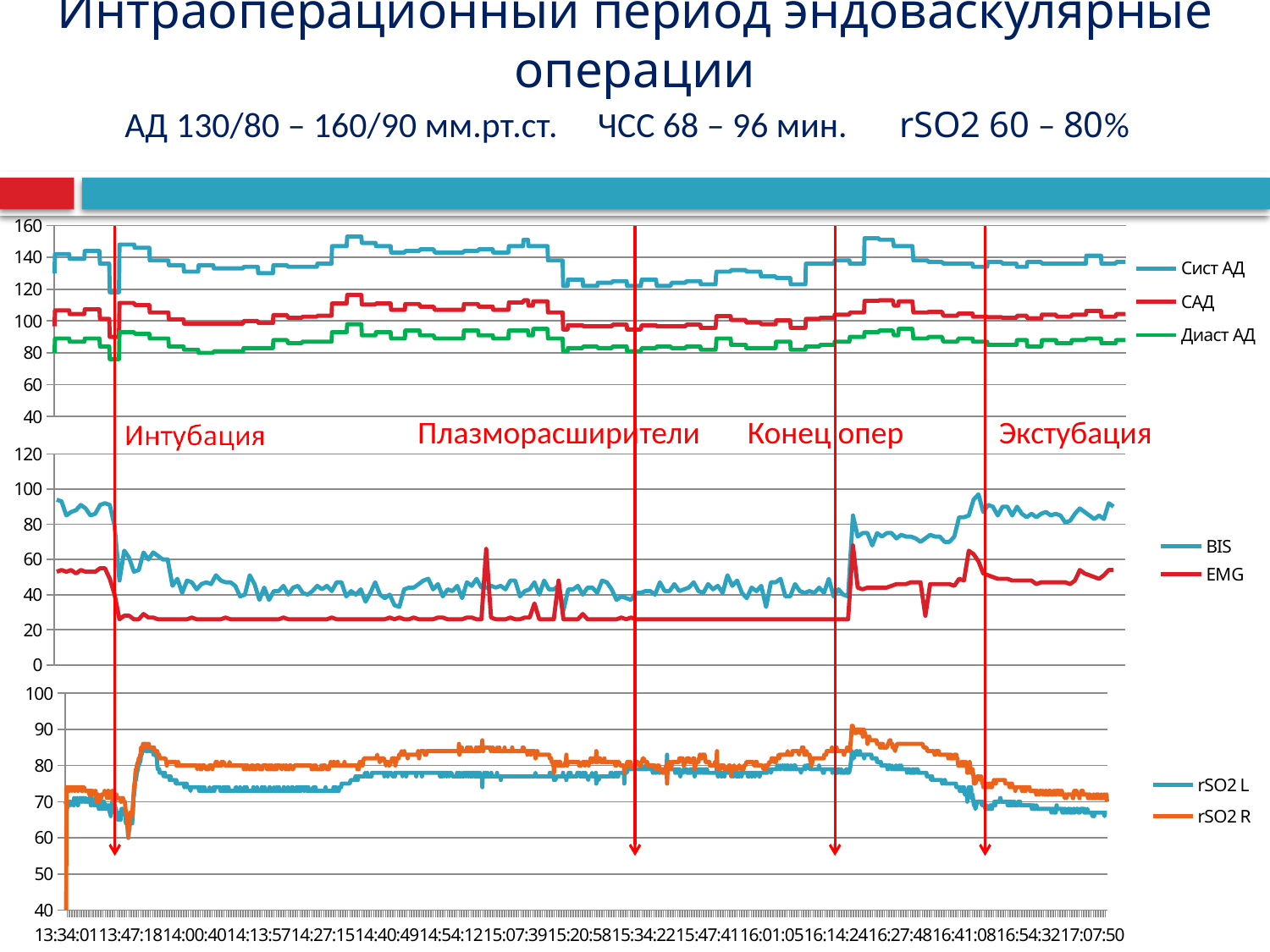
What kind of chart is the top chart (Сист АД, САД, Диаст АД)? line chart How many series does the legend of the top chart list? 3 How many series does the legend of the bottom chart list? 2 In the top chart, is the value of Сист АД at the start of the recording greater or less than 120? greater In the bottom chart, do the rSO2 L and rSO2 R values rise or fall after the Экстубация marker? fall In the middle chart, is the EMG value between the Плазморасширители and Конец опер markers greater or less than 40? less How many series does the legend of the middle chart list? 2 In the top chart, which series is higher throughout, Сист АД or Диаст АД? Сист АД In the bottom chart, is the value of rSO2 R at the end of the recording greater or less than 80? less Which series are listed in the legend of the middle chart? BIS, EMG What are the four red event labels marked on the charts? Интубация, Плазморасширители, Конец опер, Экстубация In the middle chart, which series has the higher value at the start of the recording, BIS or EMG? BIS